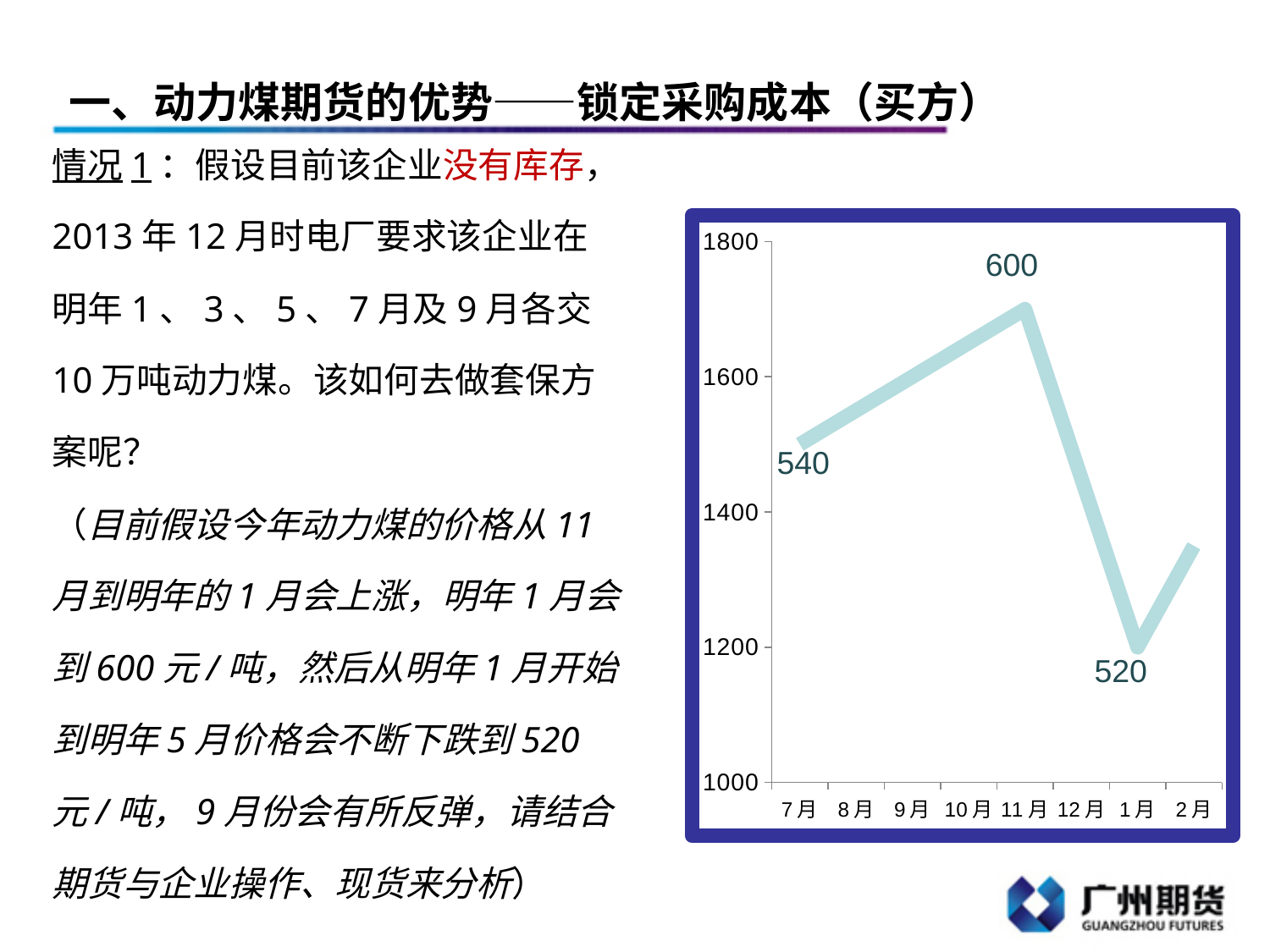
Is the plotted point for 2月 greater or less than 1400 on the y axis? less Which is larger, the labelled value at 7月 or at 1月? 7月 What data label is shown at 11月 on the chart? 600 What kind of chart is shown on the slide? line chart Which month has the highest labelled value on the chart? 11月 What data label is shown at 7月 on the chart? 540 Which month has the lowest labelled value on the chart? 1月 How many months are shown on the x axis of the chart? 8 What is the difference between the labelled values at 11月 and 1月? 80 What data label is shown at 1月 on the chart? 520 Does the line rise or fall from 11月 to 1月? fall What is the difference between the labelled values at 11月 and 7月? 60